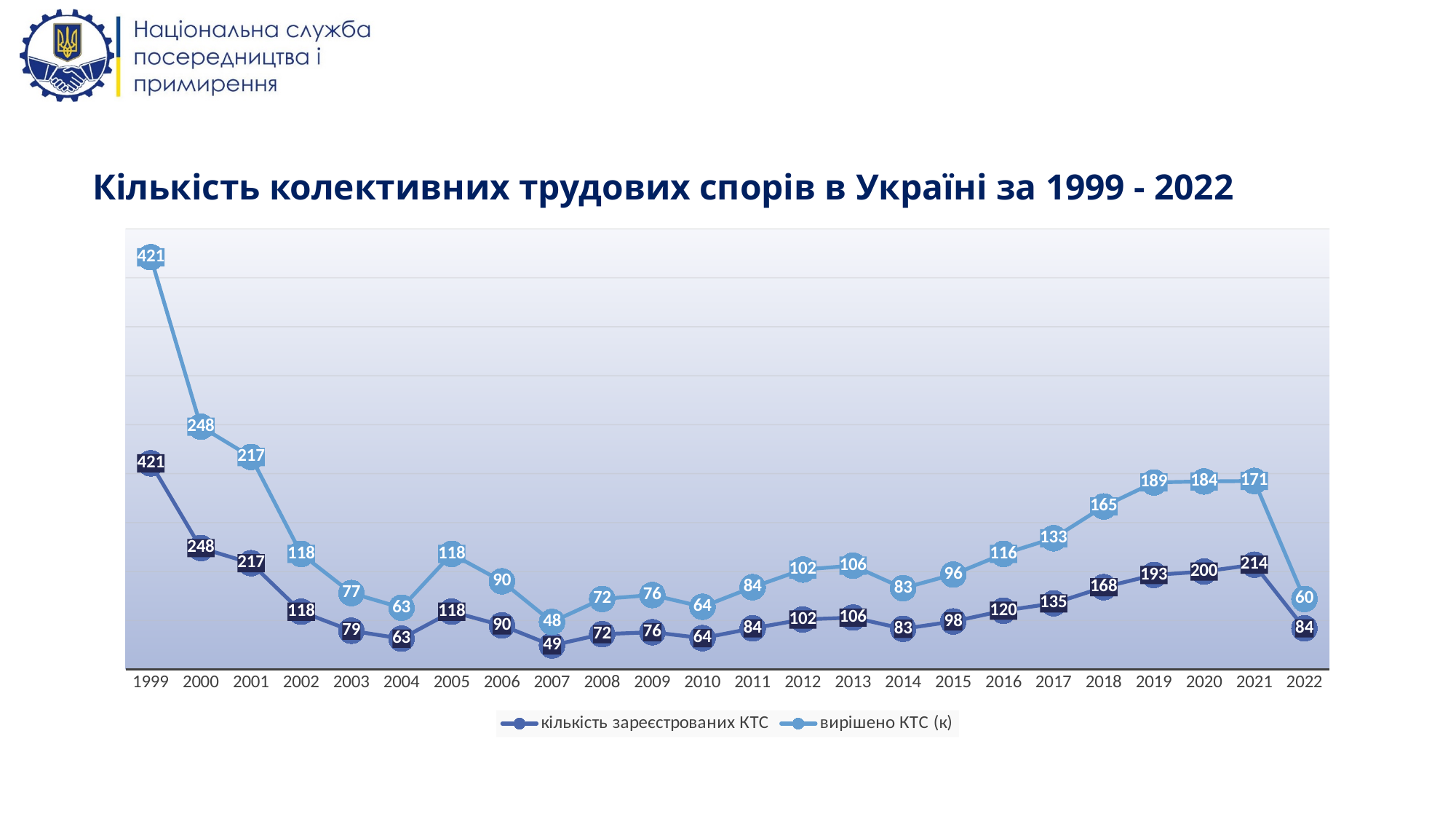
What type of chart is shown on the slide? line chart Which is larger in 2020: 'кількість зареєстрованих КТС' or 'вирішено КТС (к)'? кількість зареєстрованих КТС What is the value of 'кількість зареєстрованих КТС' in 2007? 49 How many years are plotted along the x axis? 24 What is the value of 'вирішено КТС (к)' in 2019? 189 Does 'кількість зареєстрованих КТС' rise or fall from 2016 to 2021? rise How many series does the legend list? 2 In which year is 'вирішено КТС (к)' highest? 1999 What is the difference between 'кількість зареєстрованих КТС' in 2021 and in 2022? 130 What is the value of 'кількість зареєстрованих КТС' in 2021? 214 In which year is 'кількість зареєстрованих КТС' lowest? 2007 What is the title of the chart? Кількість колективних трудових спорів в Україні за 1999 - 2022